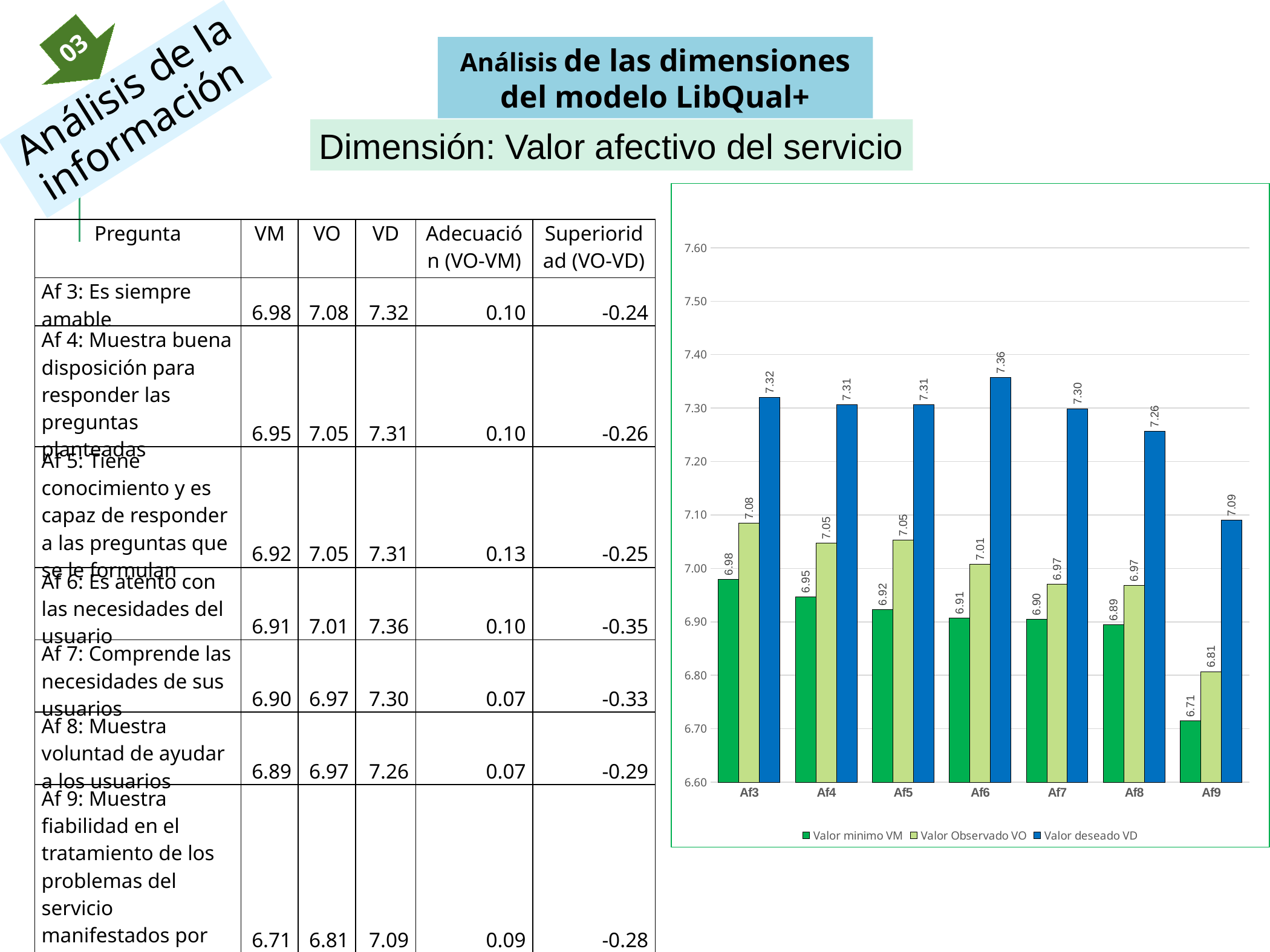
What is the Valor deseado VD value for Af6? 7.36 Is the Valor Observado VO value for Af9 greater or less than 7.00? less What kind of chart is shown on the slide? bar chart How many series does the chart legend list? 3 What is the Valor minimo VM value for Af9? 6.71 What is the Valor Observado VO value for Af3? 7.08 Do the Valor minimo VM values rise or fall from Af3 to Af9? fall What is the difference between the Valor deseado VD and Valor Observado VO values for Af6? 0.35 Which category has the lowest Valor minimo VM value? Af9 How many categories are shown on the x axis of the chart? 7 Which is larger for Af9: the Valor Observado VO value or the Valor deseado VD value? Valor deseado VD Which category has the highest Valor deseado VD value? Af6